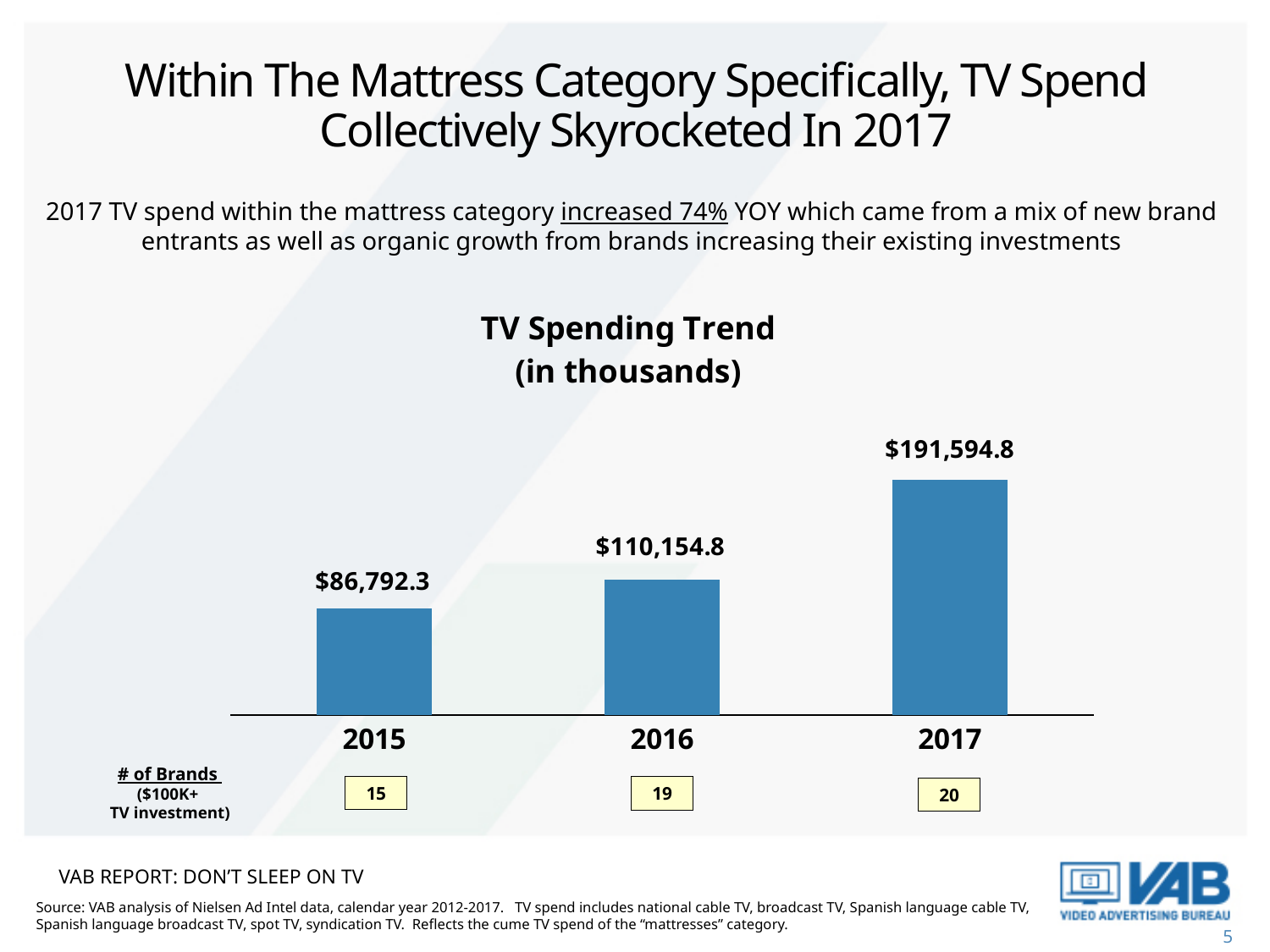
What is the difference between the TV spend in 2016 and in 2015? $23,362.5 What is the difference between the TV spend in 2017 and in 2016? $81,440.0 What is the TV spend value shown for 2016? $110,154.8 What is the TV spend value shown for 2017? $191,594.8 How many years are shown in the TV Spending Trend chart? 3 Which year has the highest TV spend in the chart? 2017 What is the title of the chart on the slide? TV Spending Trend (in thousands) Which year has a larger TV spend, 2015 or 2016? 2016 Which year has the lowest TV spend in the chart? 2015 What kind of chart is used to show the TV Spending Trend? Bar chart Do the TV spend values rise or fall from 2015 to 2017? Rise What is the TV spend value shown for 2015? $86,792.3